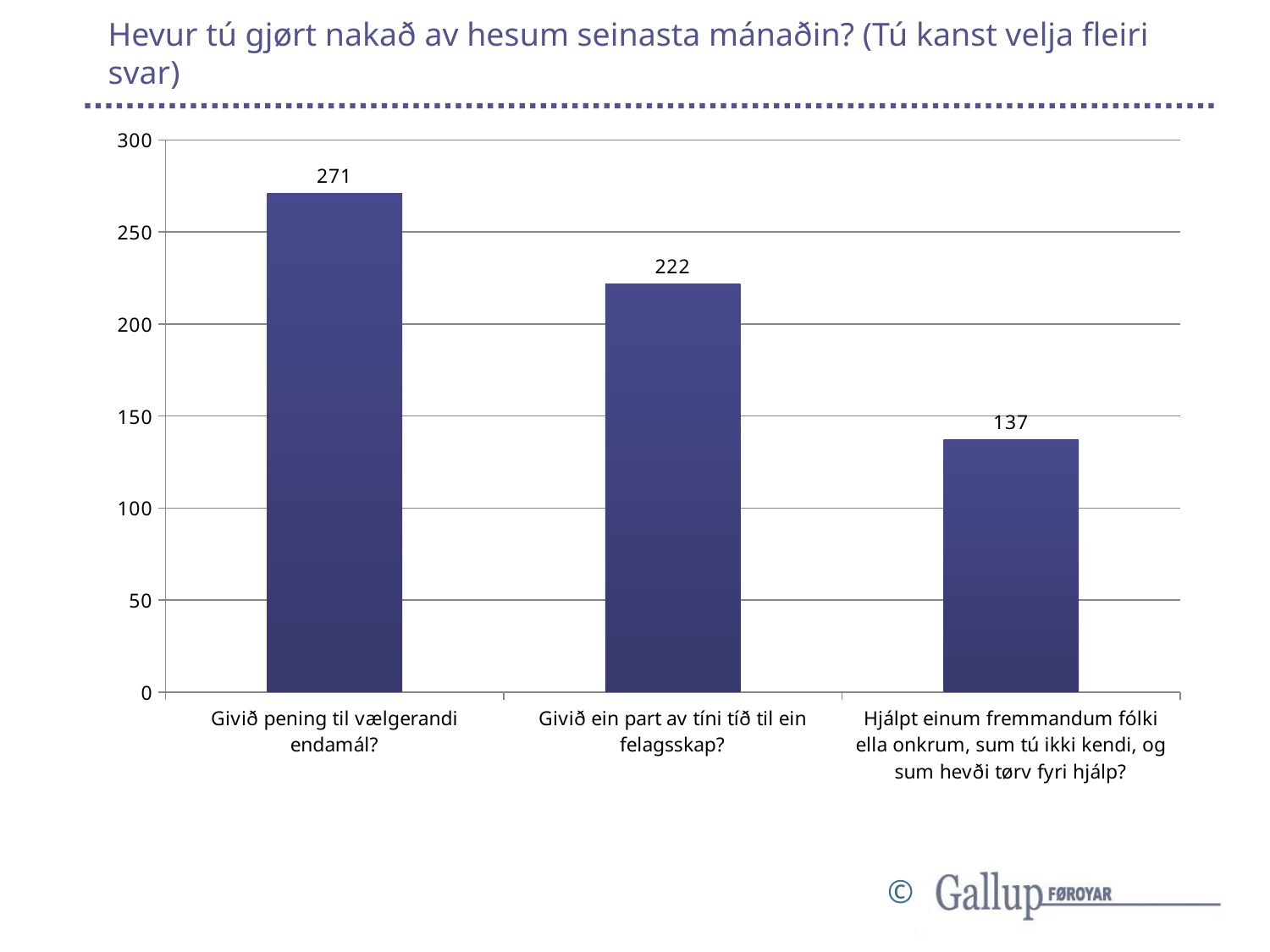
What is the difference between the values for "Givið ein part av tíni tíð til ein felagsskap?" and "Hjálpt einum fremmandum fólki ella onkrum, sum tú ikki kendi, og sum hevði tørv fyri hjálp?"? 85 Is the value for "Hjálpt einum fremmandum fólki ella onkrum, sum tú ikki kendi, og sum hevði tørv fyri hjálp?" greater or less than 150? less Which category has the highest value? Givið pening til vælgerandi endamál? What is the value for "Givið pening til vælgerandi endamál?"? 271 What kind of chart is shown on the slide? bar chart Do the values rise or fall from left to right across the categories? fall What is the difference between the values for "Givið pening til vælgerandi endamál?" and "Givið ein part av tíni tíð til ein felagsskap?"? 49 What is the value for "Givið ein part av tíni tíð til ein felagsskap?"? 222 How many categories are shown in the chart? 3 Which is larger: the value for "Givið ein part av tíni tíð til ein felagsskap?" or the value for "Hjálpt einum fremmandum fólki ella onkrum, sum tú ikki kendi, og sum hevði tørv fyri hjálp?"? Givið ein part av tíni tíð til ein felagsskap? What is the value for "Hjálpt einum fremmandum fólki ella onkrum, sum tú ikki kendi, og sum hevði tørv fyri hjálp?"? 137 Which category has the lowest value? Hjálpt einum fremmandum fólki ella onkrum, sum tú ikki kendi, og sum hevði tørv fyri hjálp?